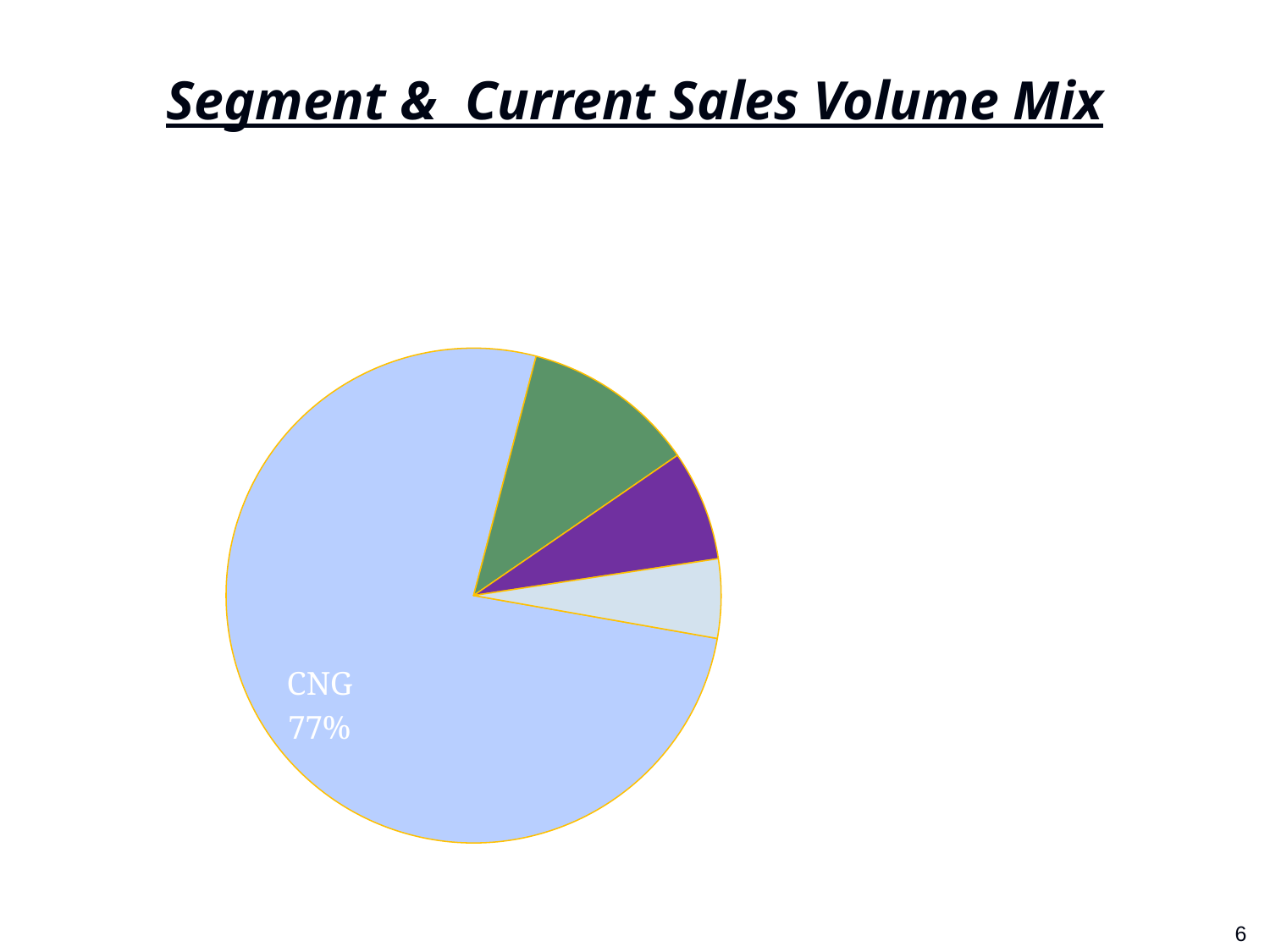
What share of the pie does the CNG slice represent? 77% Which is larger, the CNG slice or the green slice? CNG How many slices does the pie chart have? 4 Which is larger, the green slice or the purple slice? the green slice What kind of chart is shown on the slide? pie chart What colour is the CNG slice of the pie chart? light blue What is the title of the slide containing the pie chart? Segment & Current Sales Volume Mix Which slice of the pie chart is the largest? CNG